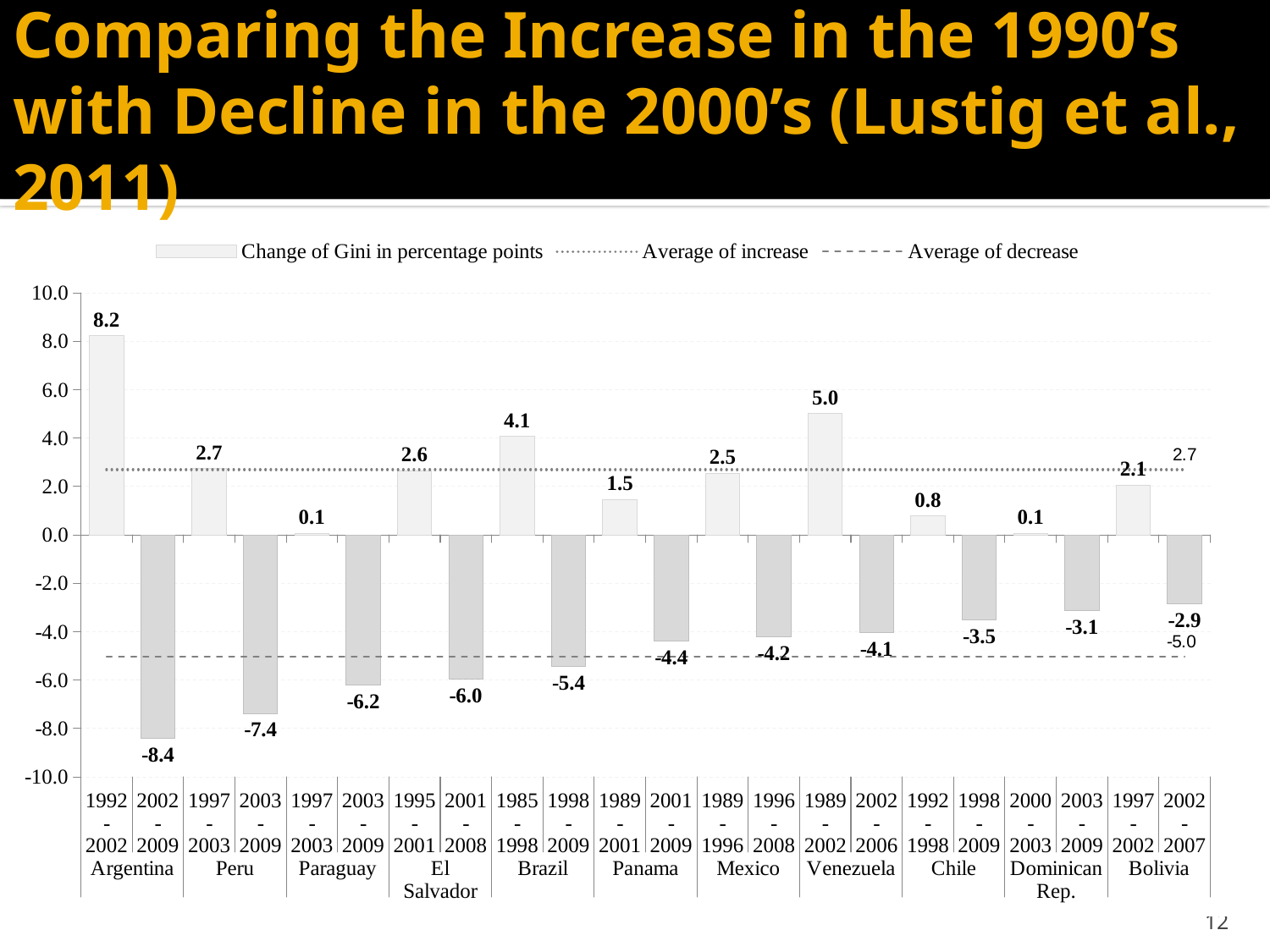
Which country-period bar has the lowest change of Gini in percentage points? Argentina 2002-2009 What is the change of Gini in percentage points for Peru in 2003-2009? -7.4 Which is larger in absolute terms: the decline for Paraguay in 2003-2009 or the decline for El Salvador in 2001-2008? Paraguay 2003-2009 How many countries are shown on the x axis of the chart? 11 What is the change of Gini in percentage points for Venezuela in 1989-2002? 5.0 What kind of chart is shown on the slide? Bar chart What value is labelled for the 'Average of decrease' line? -5.0 Which country-period bar has the highest change of Gini in percentage points? Argentina 1992-2002 Is the change of Gini for Chile in 1998-2009 greater or less than -4.0? greater What is the difference between the change of Gini for Brazil in 1985-1998 (4.1) and Mexico in 1989-1996 (2.5)? 1.6 What is the change of Gini in percentage points for Argentina in 1992-2002? 8.2 How many entries does the chart legend list? 3